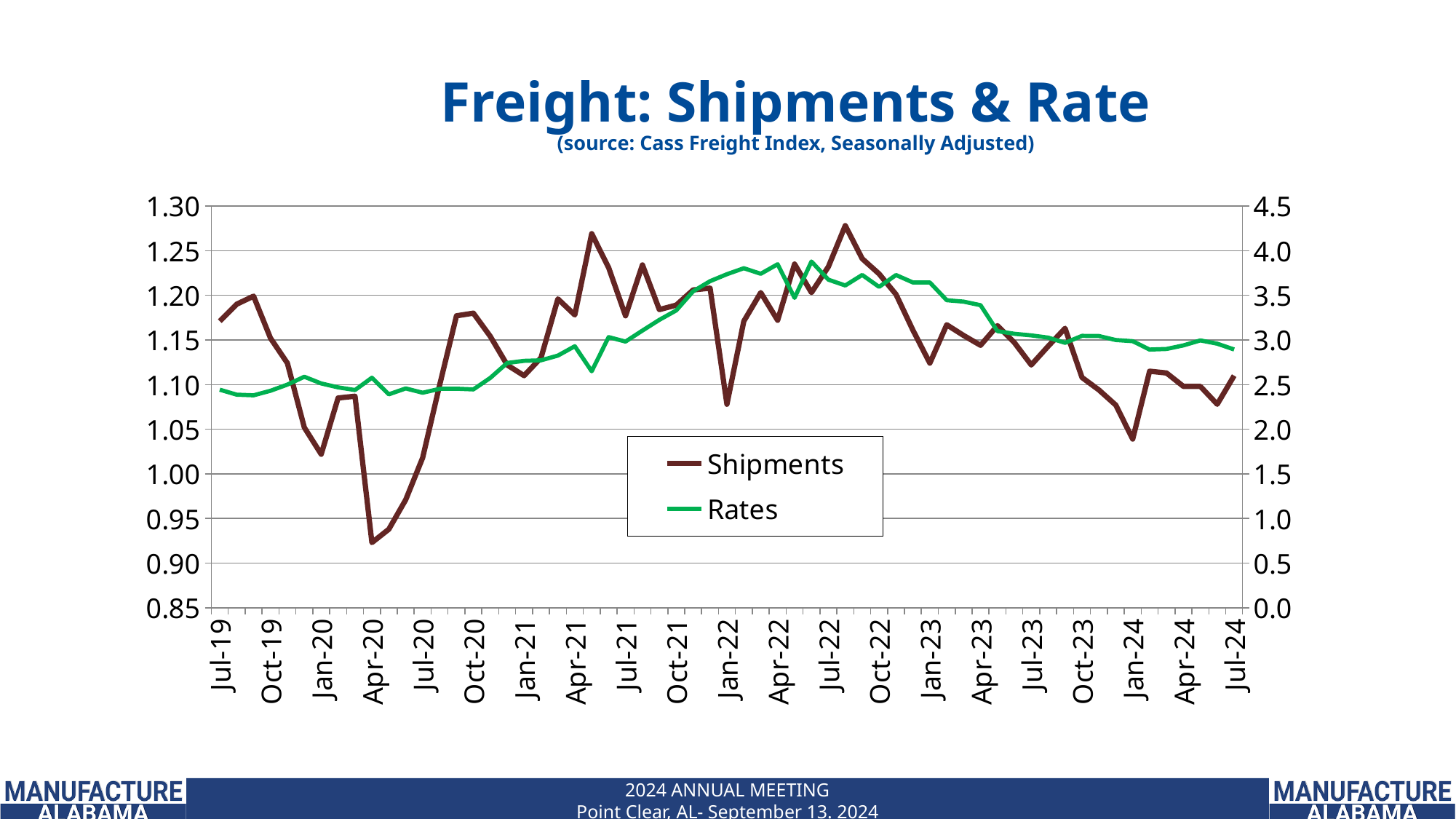
What is the title of the chart? Freight: Shipments & Rate Is the Rates value at Jul-19 greater or less than 3.0? less Which series is drawn in green? Rates Do Rates generally rise or fall from Jul-22 to Jul-24? fall Is the Shipments value at Jul-19 greater or less than 1.15? greater Is the Shipments value at Apr-20 greater or less than 0.95? less Which is larger, the Rates value at Jan-20 or at Jan-22? Jan-22 How many series does the legend list? 2 Which month shows the lowest Shipments value? Apr-20 What kind of chart is shown on the slide? Line chart Which is larger, the Shipments value at Jul-19 or at Jul-24? Jul-19